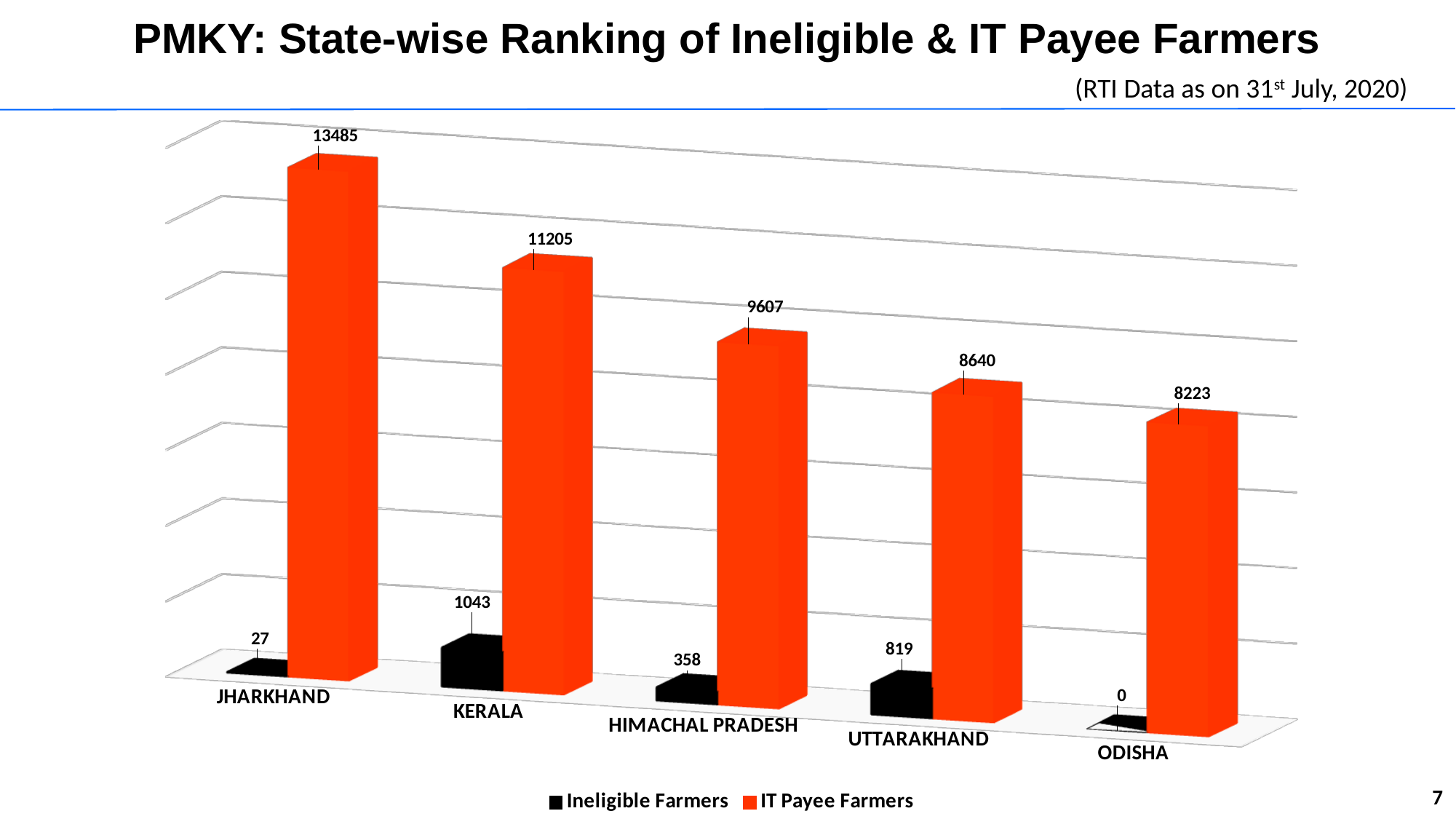
How many states are shown on the chart? 5 What is the difference between the IT Payee Farmers values for Jharkhand and Kerala? 2280 What is the value for Ineligible Farmers in Uttarakhand? 819 Which is larger: Ineligible Farmers in Himachal Pradesh or in Uttarakhand? Uttarakhand What is the value for IT Payee Farmers in Odisha? 8223 How many series does the legend list? 2 What is the value for IT Payee Farmers in Jharkhand? 13485 Which state has the lowest value for Ineligible Farmers? Odisha What kind of chart is shown on the slide? Bar chart Which state has the highest value for IT Payee Farmers? Jharkhand Do the IT Payee Farmers values rise or fall from Jharkhand to Odisha? Fall What is the value for Ineligible Farmers in Kerala? 1043